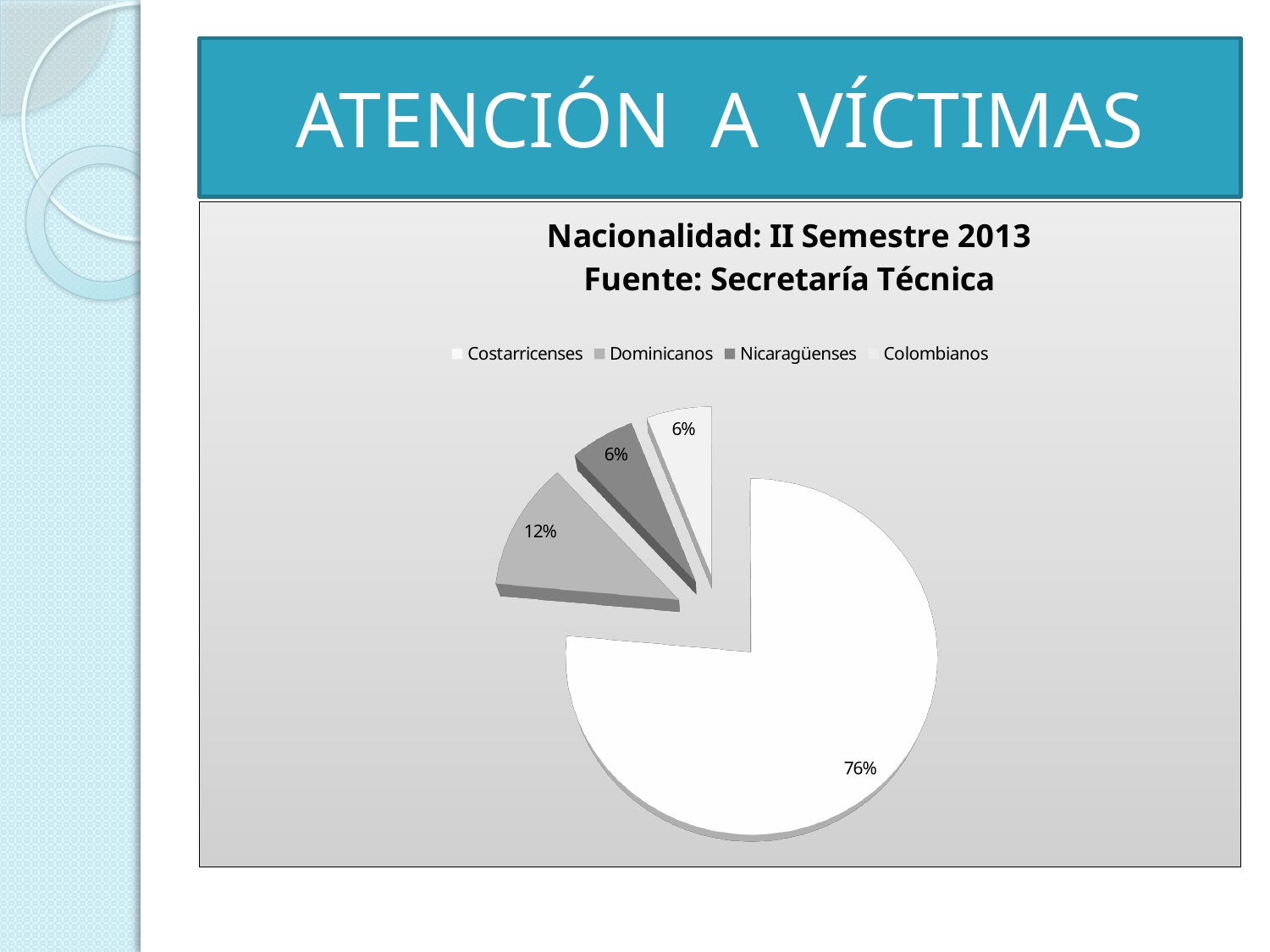
How many categories does the pie chart have? 4 What is the difference in percentage points between Costarricenses and Dominicanos? 64 What is the title of the chart? Nacionalidad: II Semestre 2013 Fuente: Secretaría Técnica Which is larger, the share for Dominicanos or the share for Nicaragüenses? Dominicanos What percentage is shown for Dominicanos? 12% What share of the pie do Costarricenses represent? 76% What percentage is shown for Colombianos? 6% Which nationality has the largest slice of the pie? Costarricenses What percentage is shown for Nicaragüenses? 6% How many entries does the legend list? 4 What type of chart is shown on the slide? pie chart What is the combined percentage of Nicaragüenses and Colombianos? 12%